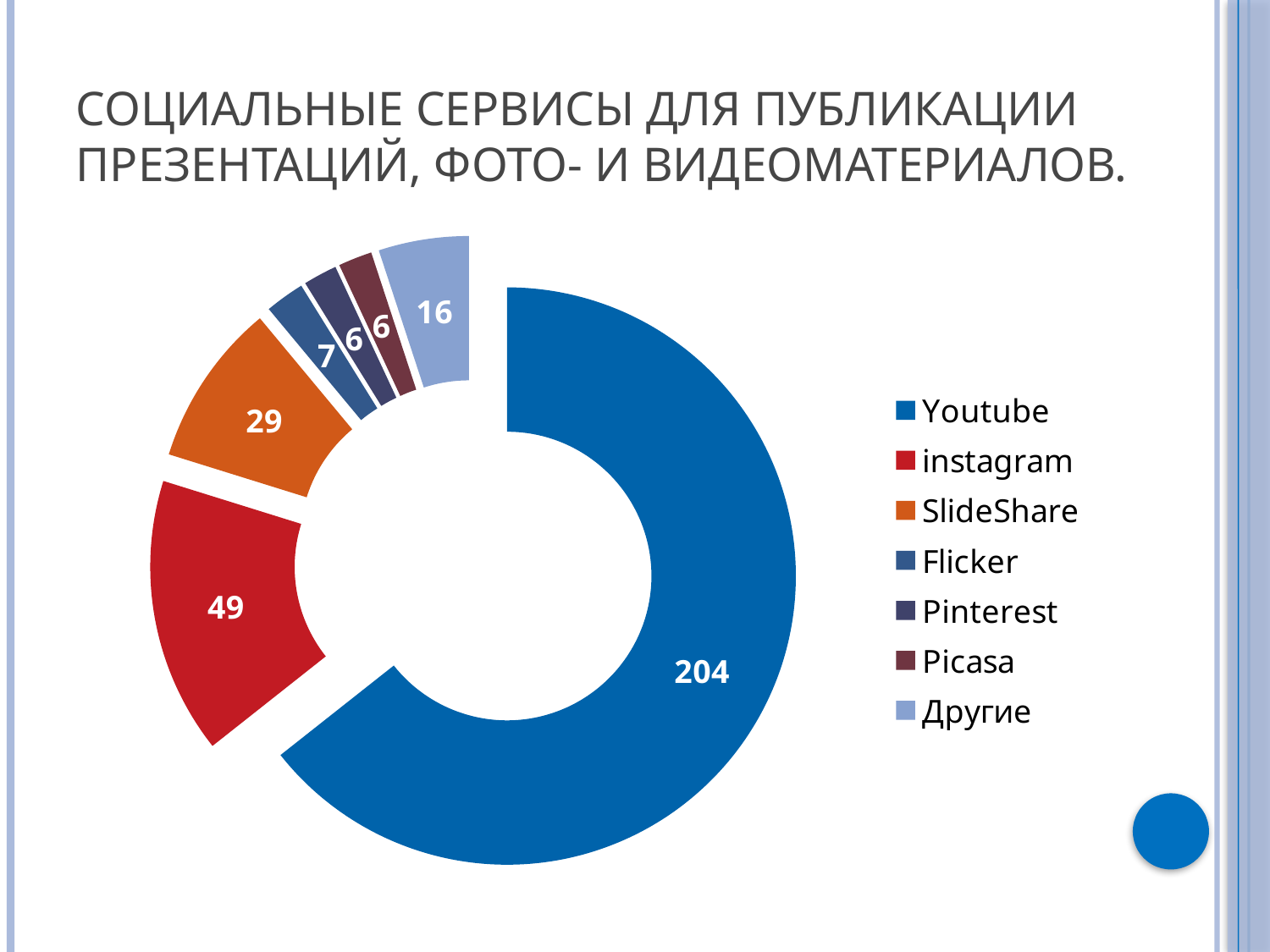
What kind of chart is shown on the slide? doughnut chart What is the difference between the values for instagram and SlideShare? 20 What is the value for Другие? 16 Which category has the highest value? Youtube What is the value for Youtube? 204 What is the difference between the values for Youtube and instagram? 155 What colour is the Youtube slice? blue How many categories are shown in the chart? 7 What is the value for Flicker? 7 What is the value for instagram? 49 What is the value for SlideShare? 29 Which is larger, the value for SlideShare or the value for Другие? SlideShare